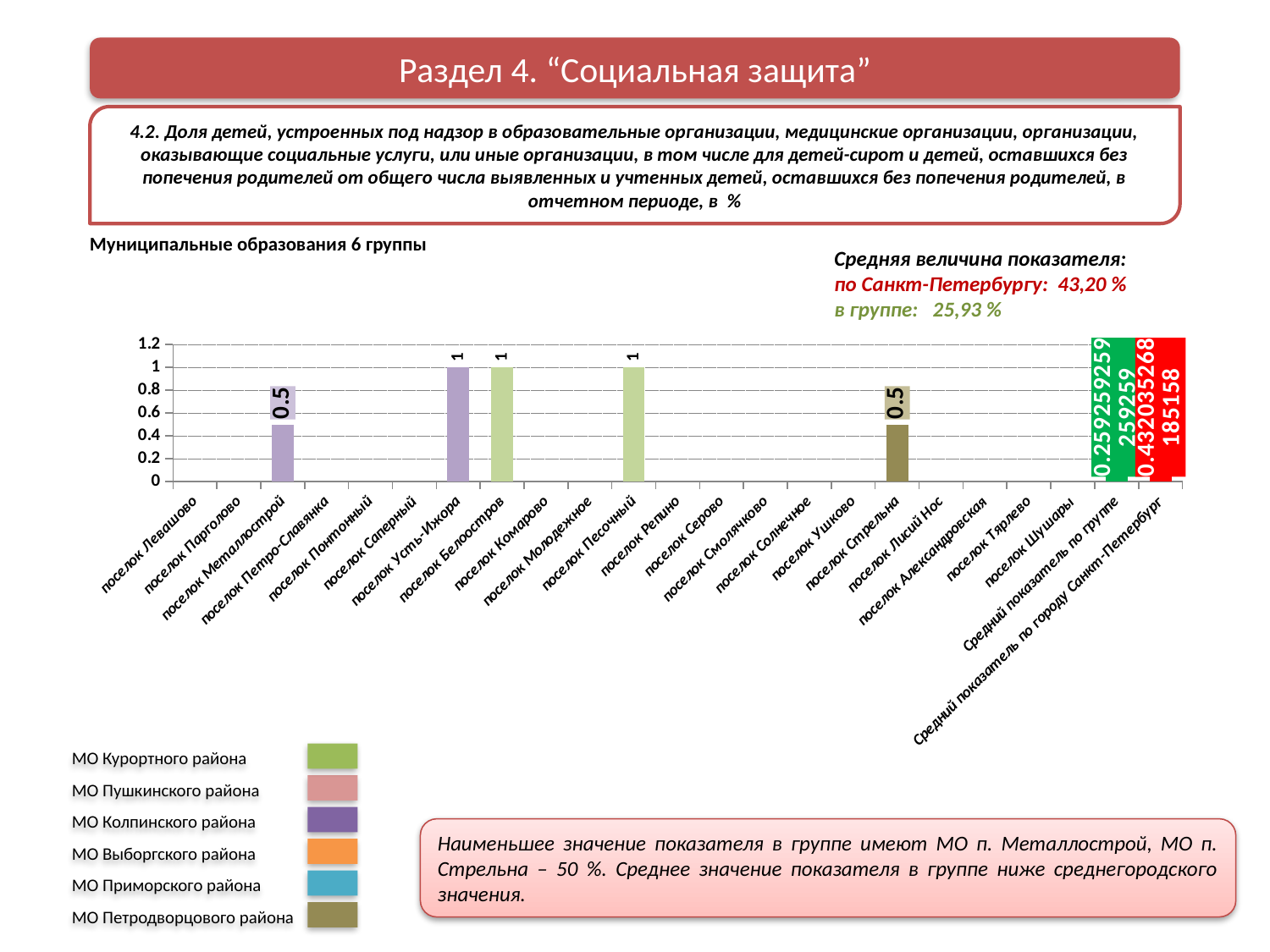
Which is larger, the value for поселок Белоостров or the value for поселок Стрельна? поселок Белоостров How many categories are shown on the x axis of the chart? 23 What is the highest value shown on the y axis of the chart? 1.2 Is the value for Средний показатель по городу Санкт-Петербург greater or less than 0.4? greater Is the value for Средний показатель по группе greater or less than 0.4? less What is the difference between the value for поселок Песочный and the value for поселок Металлострой? 0.5 What kind of chart is shown on the slide? bar chart What is the value for поселок Стрельна? 0.5 What is the value for поселок Усть-Ижора? 1 What is the value for поселок Белоостров? 1 How many entries does the legend below the chart list? 6 What is the value for поселок Металлострой? 0.5